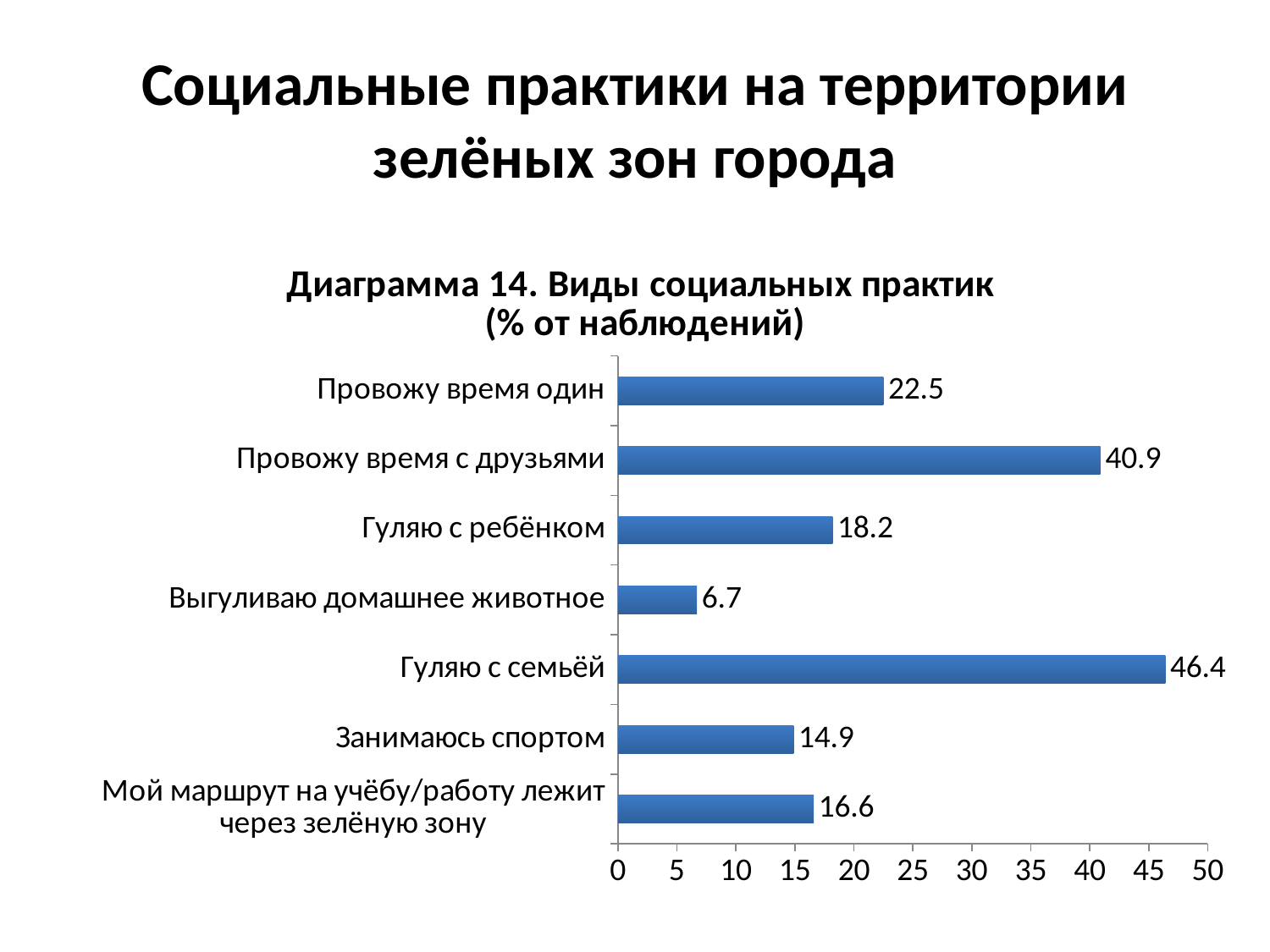
What is the title of the chart? Диаграмма 14. Виды социальных практик (% от наблюдений) What is the value for «Провожу время с друзьями»? 40.9 Which category has the highest value? Гуляю с семьёй Which category has the lowest value? Выгуливаю домашнее животное What is the difference between the values for «Гуляю с семьёй» and «Провожу время с друзьями»? 5.5 How many categories are shown in the chart? 7 Which is larger: the value for «Провожу время один» or the value for «Гуляю с ребёнком»? Провожу время один What is the value for «Выгуливаю домашнее животное»? 6.7 What is the value for «Мой маршрут на учёбу/работу лежит через зелёную зону»? 16.6 What is the value for «Гуляю с семьёй»? 46.4 What kind of chart is shown on the slide? bar chart Is the value for «Занимаюсь спортом» greater or less than 20? less